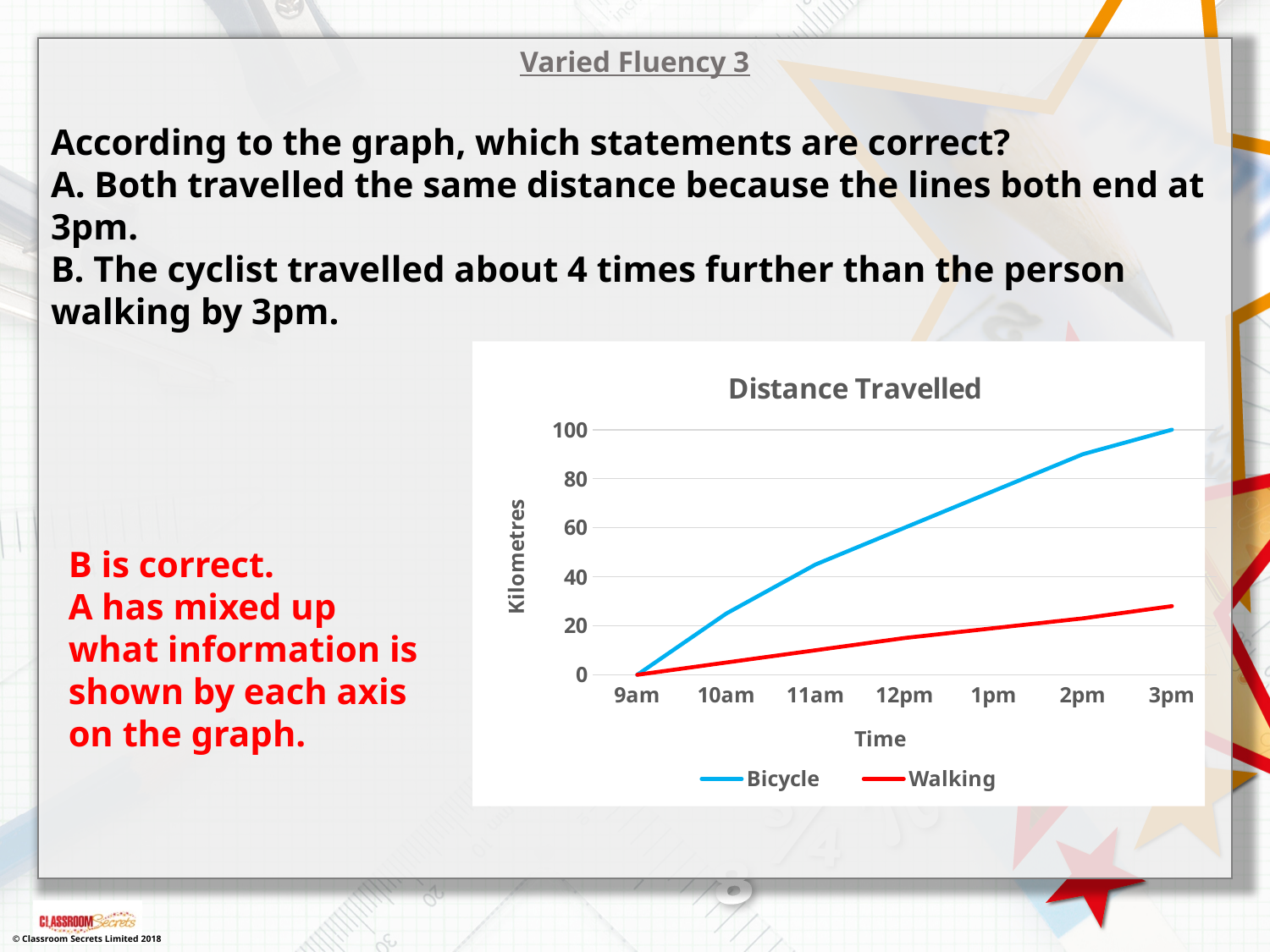
Which series has the larger value at 1pm, Bicycle or Walking? Bicycle Is the Bicycle value at 12pm greater or less than 40? greater Is the Walking value at 12pm greater or less than 20? less What is the Bicycle value at 3pm? 100 What is the Walking value at 9am? 0 What is the title of the chart? Distance Travelled What is the label of the vertical axis of the chart? Kilometres How many time points are shown on the x axis of the Distance Travelled chart? 7 Is the Walking value at 3pm greater or less than 40? less What kind of chart is shown on the slide? line chart How many series does the legend of the Distance Travelled chart list? 2 Do the Bicycle values rise or fall from 9am to 3pm? rise